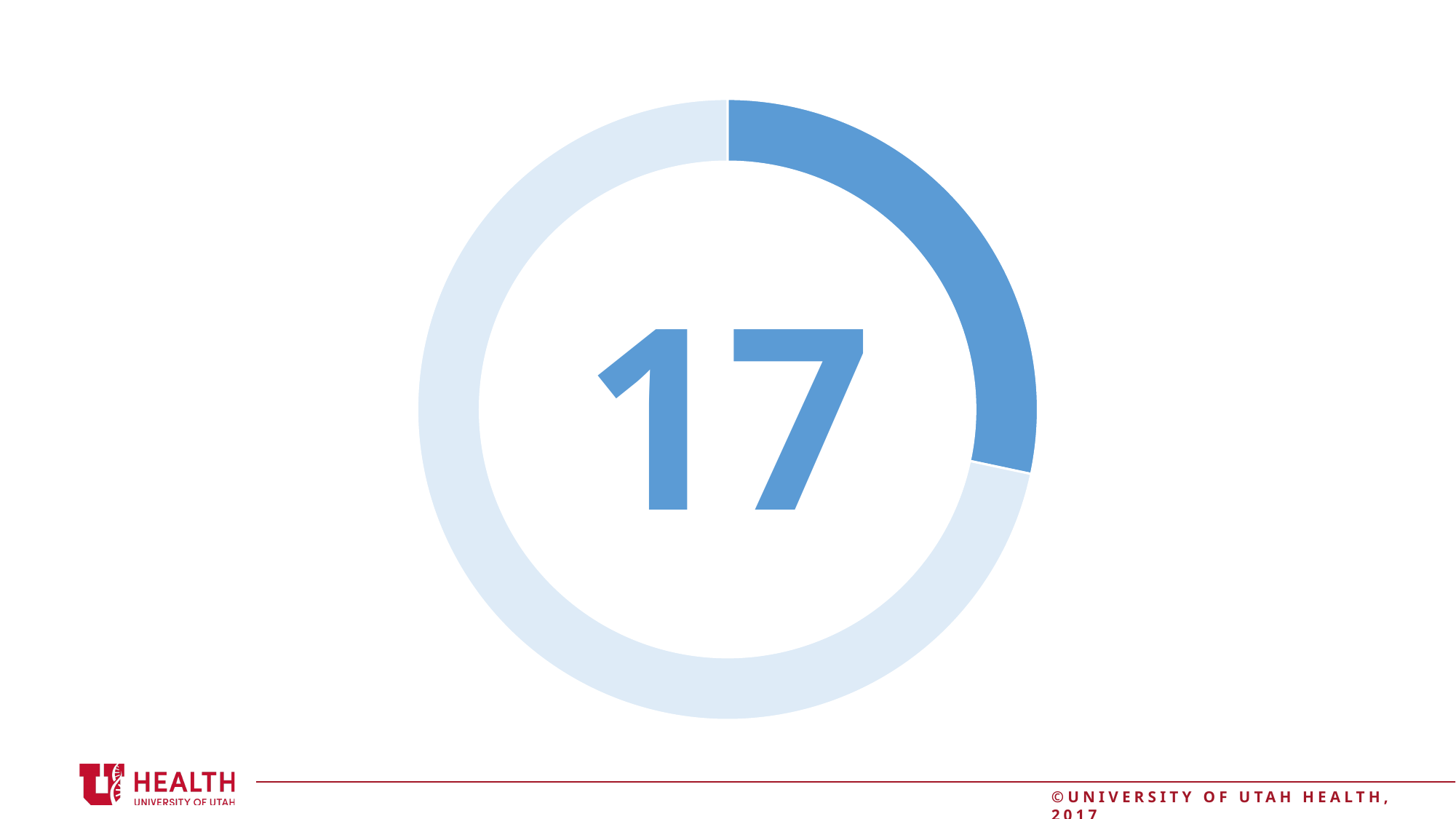
Does the doughnut chart have a legend? No How many segments does the doughnut chart have? 2 What kind of chart is shown on the slide? doughnut chart Does the dark blue segment cover more or less than half of the ring? less Which segment of the doughnut chart is larger, the dark blue one or the light blue one? the light blue one What number is printed in the centre of the doughnut chart? 17 What colour is the smaller segment of the doughnut chart? dark blue